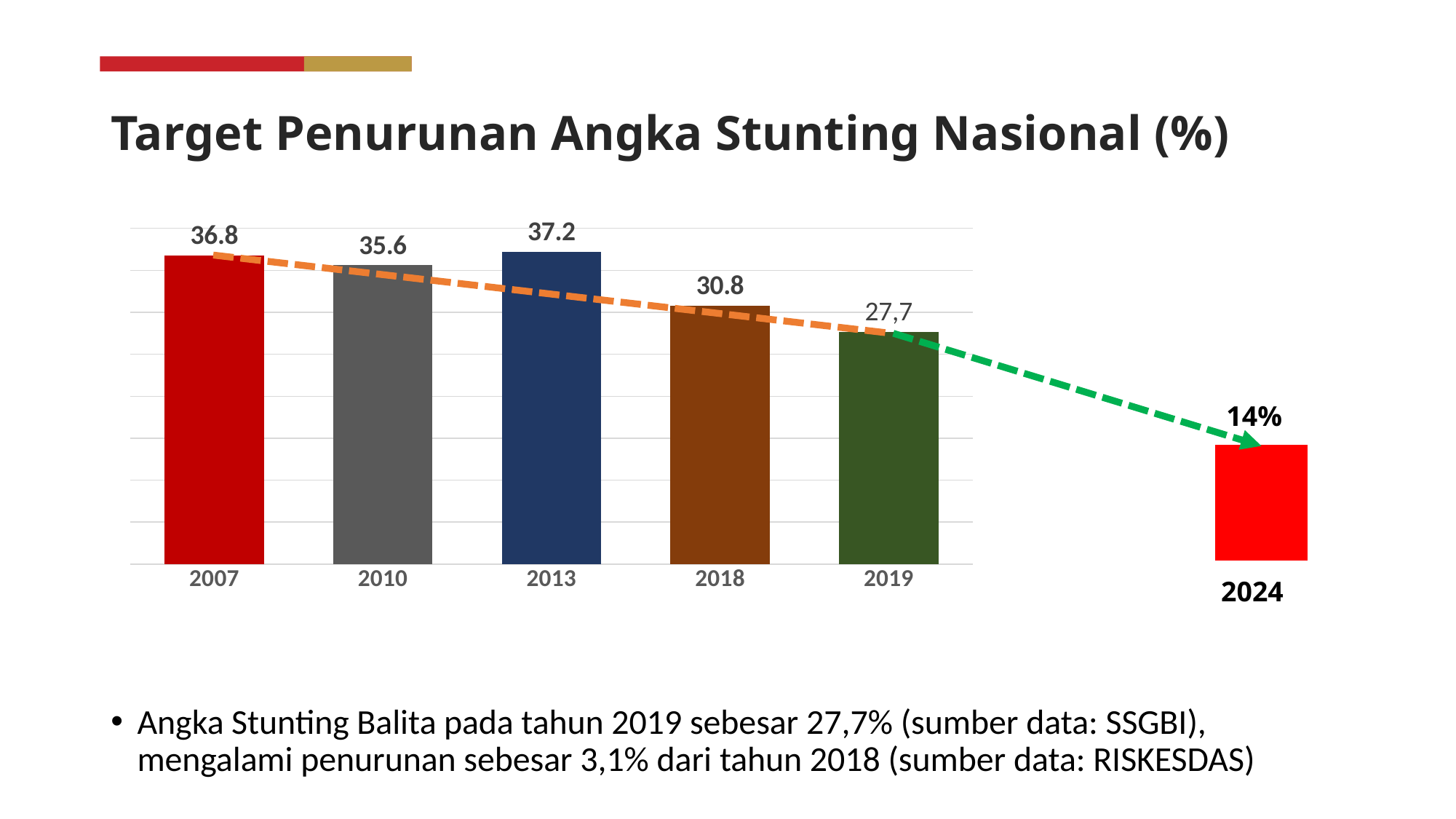
What is the difference between the values for 2007 and 2010? 1.2 What is the target value shown for 2024? 14% What is the value shown for 2013? 37.2 Which year from 2007 to 2019 has the lowest stunting rate? 2019 From 2013 to 2019, do the values rise or fall? Fall What is the value shown for 2019? 27,7 Which year from 2007 to 2019 has the highest stunting rate? 2013 What is the difference between the values for 2018 and 2019? 3.1 How many years from 2007 to 2019 are plotted as bars in the chart? 5 What kind of chart is shown on the slide? Bar chart What is the stunting rate shown for 2007? 36.8 Which is larger, the value for 2010 or the value for 2018? 2010